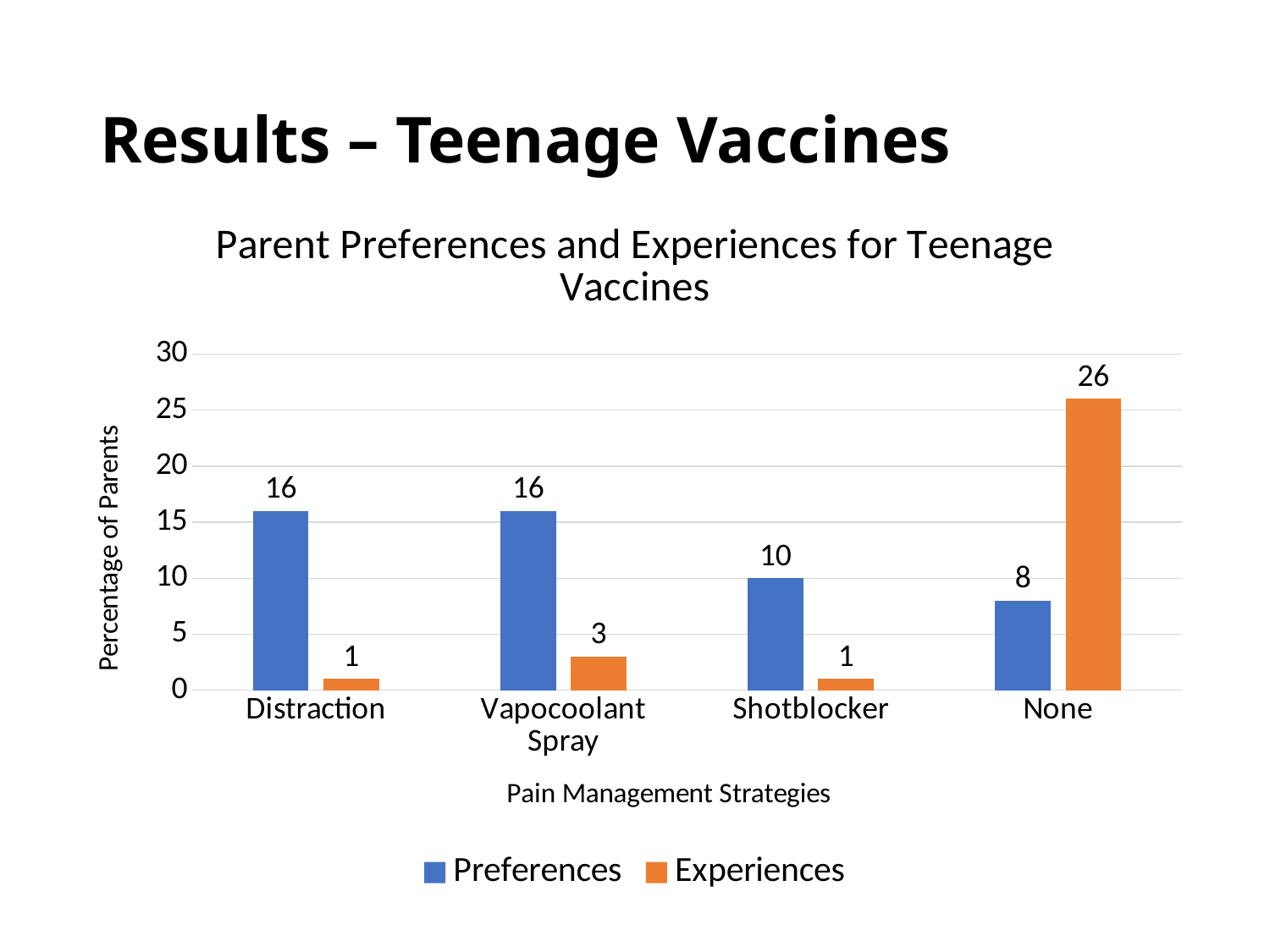
How many series does the legend list? 2 Which category has the lowest Preferences value? None What is the Experiences value for Vapocoolant Spray? 3 Which is larger for Shotblocker, Preferences or Experiences? Preferences Which category has the highest Experiences value? None What kind of chart is shown? Bar chart What is the title of the chart? Parent Preferences and Experiences for Teenage Vaccines What is the Preferences value for Distraction? 16 How many pain management strategies are shown on the x axis? 4 What is the Experiences value for None? 26 What is the difference between the Experiences and Preferences values for None? 18 What is the Preferences value for Shotblocker? 10